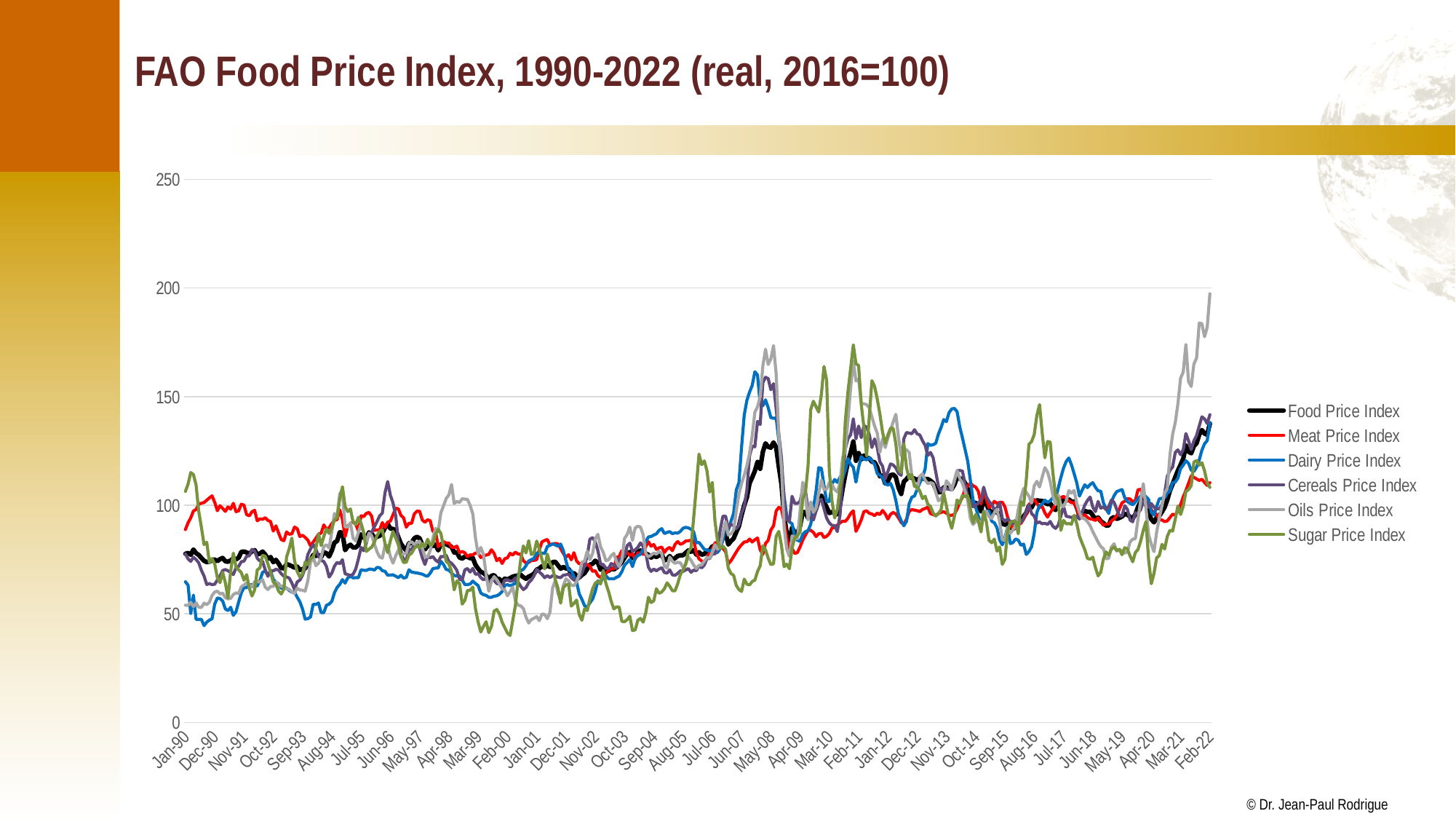
Does the Oils Price Index rise or fall between Apr-20 and Feb-22? rise What is the highest value shown on the vertical axis? 250 Which series reaches the highest value at Feb-22, the right end of the chart? Oils Price Index How many series does the legend list? 6 What kind of chart is shown on the slide? line chart Is the value of the Cereals Price Index at Jan-90 greater or less than 100? less Does the Food Price Index rise or fall between May-08 and Apr-09? fall Is the peak of the Sugar Price Index around Feb-11 greater or less than 150? greater Is the value of the Food Price Index at Jan-90 greater or less than 100? less What is the title of the chart? FAO Food Price Index, 1990-2022 (real, 2016=100)